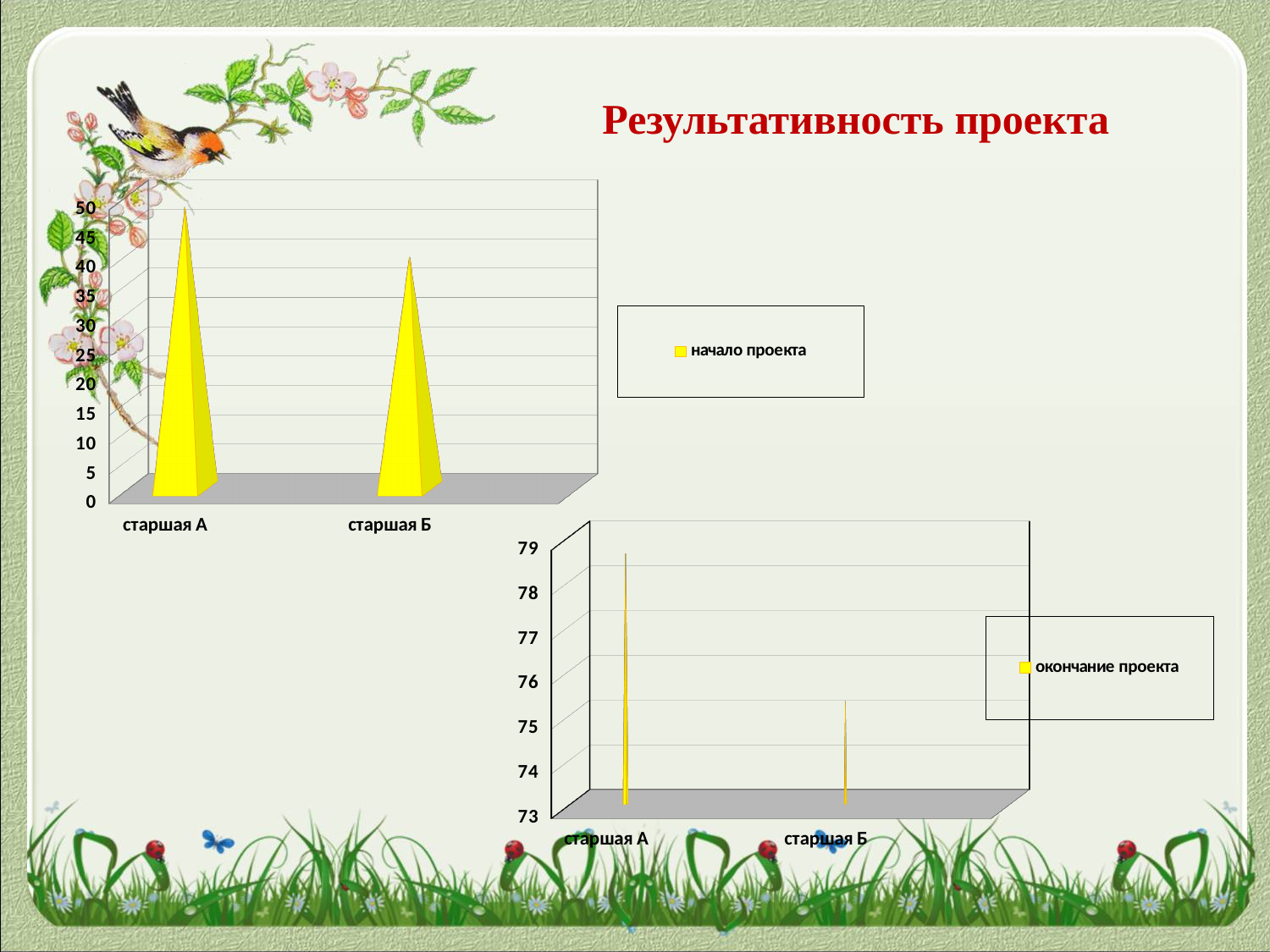
In the bottom chart (legend 'окончание проекта'), is the value for старшая А greater or less than 78? greater In the bottom chart (legend 'окончание проекта'), how many series does the legend list? 1 In the top chart (legend 'начало проекта'), is the value for старшая А greater or less than 45? greater What kind of chart is the bottom chart (legend 'окончание проекта')? bar chart What kind of chart is the top chart (legend 'начало проекта')? bar chart In the bottom chart (legend 'окончание проекта'), which is larger, the value for старшая А or старшая Б? старшая А In the bottom chart (legend 'окончание проекта'), which category has the lowest value? старшая Б In the top chart (legend 'начало проекта'), how many categories are shown on the x axis? 2 What is the legend entry of the top chart? начало проекта In the top chart (legend 'начало проекта'), is the value for старшая Б greater or less than 35? greater In the top chart (legend 'начало проекта'), which category has the highest value? старшая А